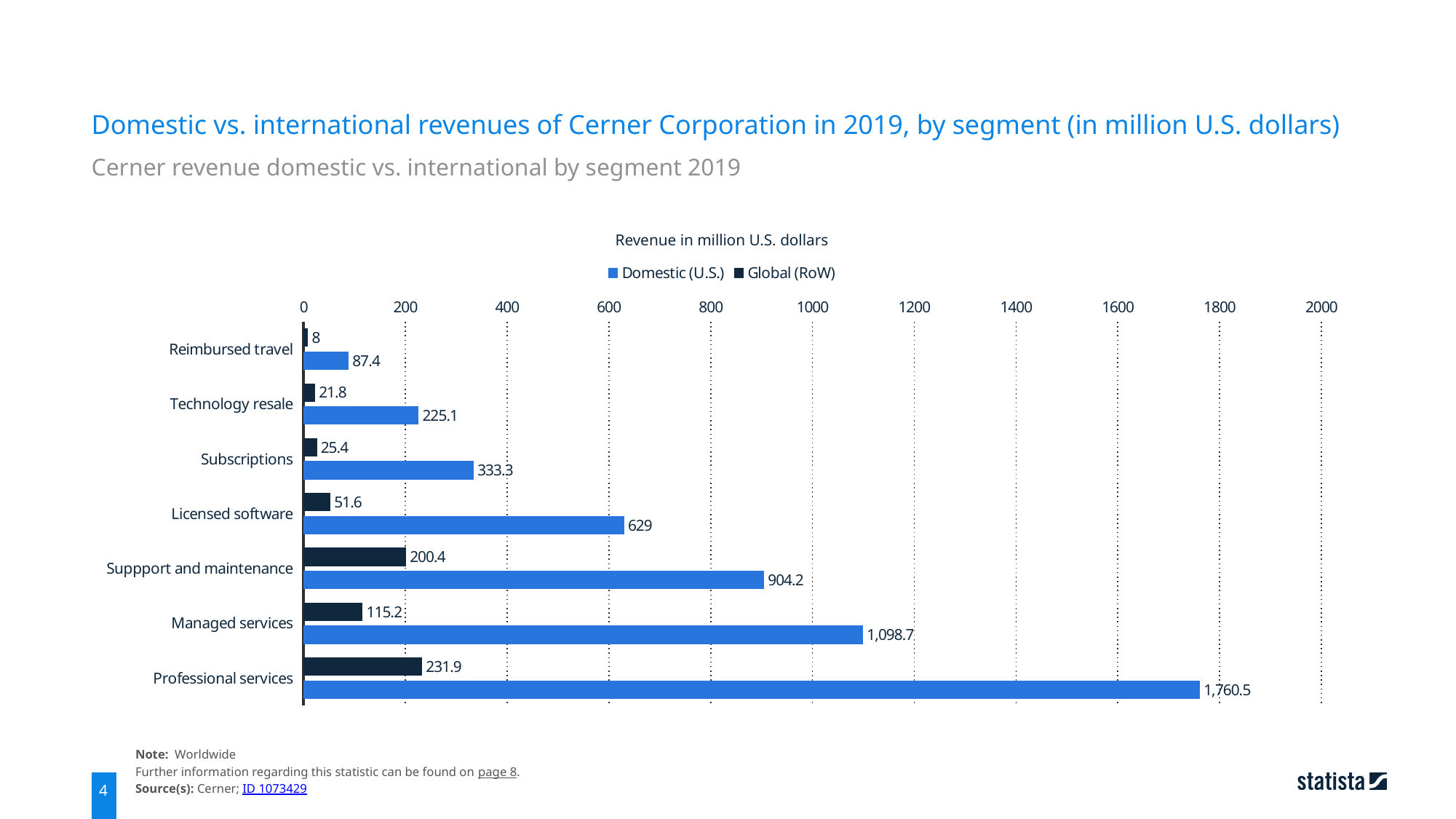
What kind of chart is shown on the slide? Bar chart Which colour represents the Global (RoW) series? Dark navy How many segments are shown on the chart? 7 What is the Domestic (U.S.) revenue for Professional services? 1,760.5 What is the Global (RoW) revenue for Support and maintenance? 200.4 How many series does the legend list? 2 What is the Domestic (U.S.) revenue for Subscriptions? 333.3 What is the difference between the Domestic (U.S.) and Global (RoW) revenue for Managed services? 983.5 Which segment has the lowest Global (RoW) revenue? Reimbursed travel Is the Domestic (U.S.) revenue for Support and maintenance greater or less than 1000? less Which segment has the highest Domestic (U.S.) revenue? Professional services Which is larger: the Global (RoW) revenue for Professional services or the Domestic (U.S.) revenue for Technology resale? Global (RoW) revenue for Professional services